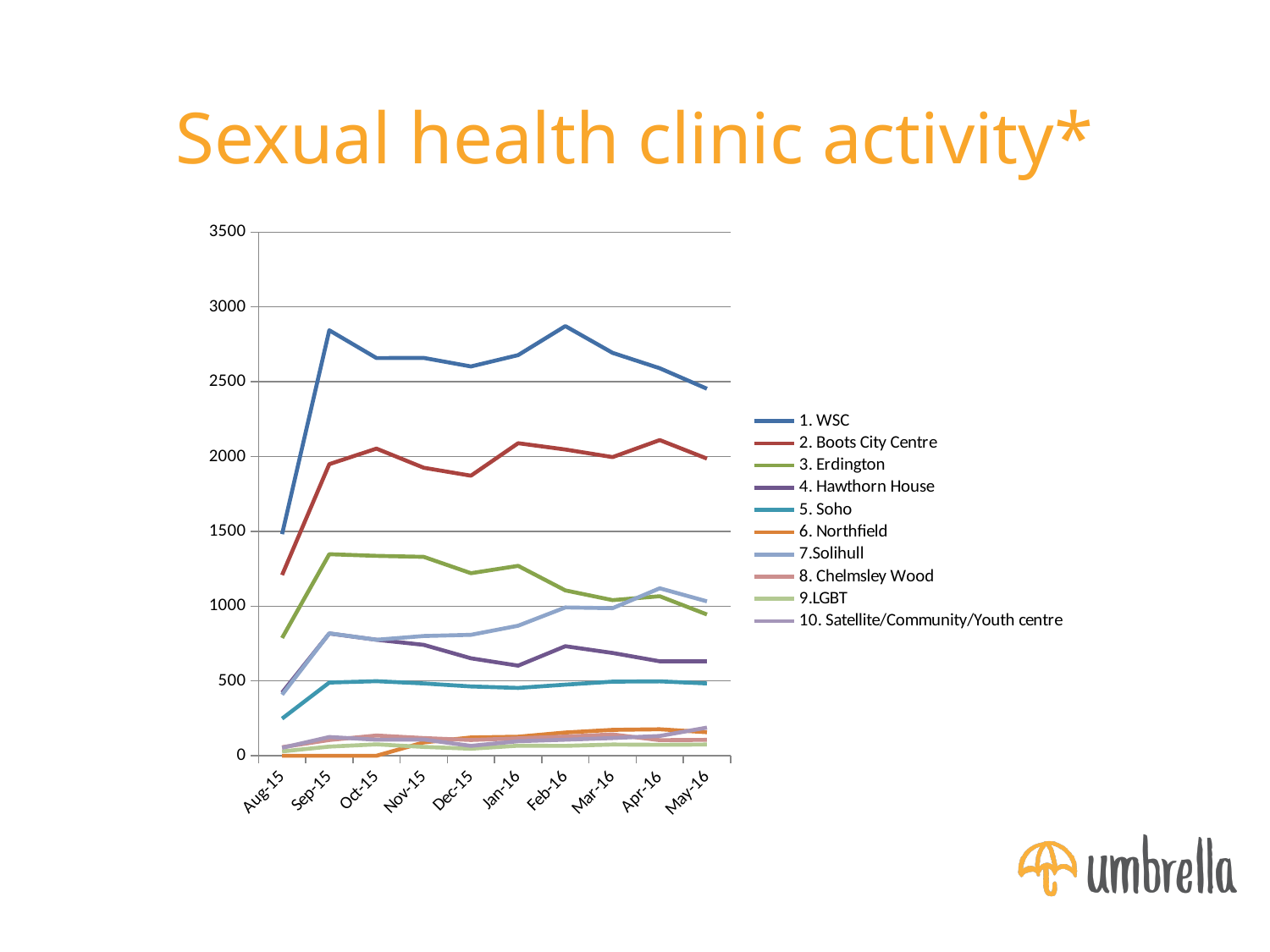
What kind of chart is shown on the slide? line chart Is the value for 2. Boots City Centre in Aug-15 greater or less than 1500? less Is the value for 7.Solihull in Apr-16 greater or less than 1000? greater What is the title of the slide? Sexual health clinic activity* Which clinic has the highest activity across the whole period? 1. WSC Is the value for 1. WSC in Feb-16 greater or less than 2500? greater How many months are shown along the x axis? 10 Which clinic has the lowest value in Aug-15? 6. Northfield Does the value for 1. WSC rise or fall from Feb-16 to May-16? fall How many series does the legend list? 10 In Sep-15, which is larger: 3. Erdington or 4. Hawthorn House? 3. Erdington